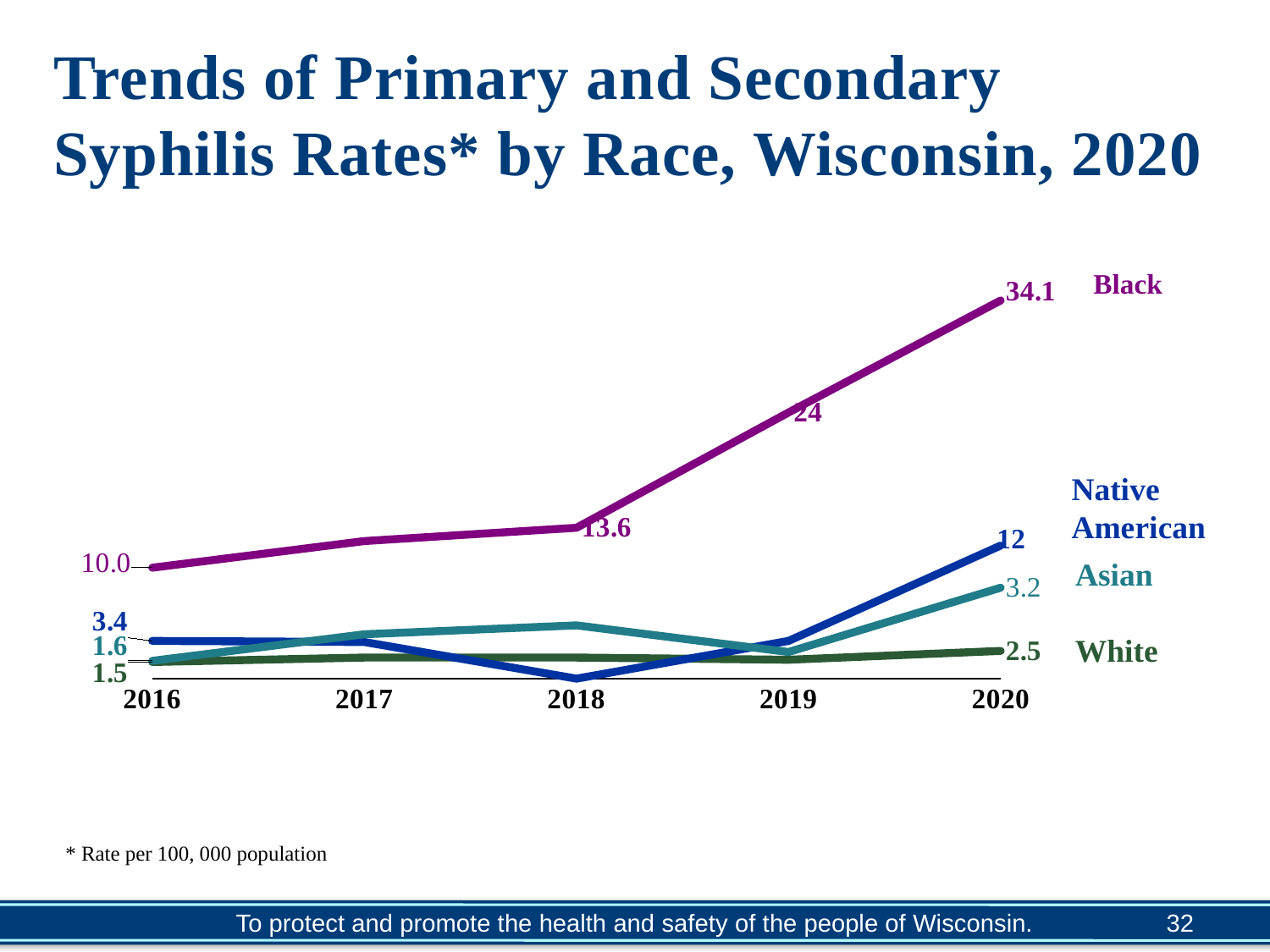
What was the rate for the Black population in 2019? 24 What was the rate for the Asian population in 2020? 3.2 What was the rate for the Native American population in 2020? 12 How many race groups are plotted as lines on the chart? 4 Which race had the lowest syphilis rate in 2020? White By how much did the rate for the Black population increase from 2019 to 2020? 10.1 What was the primary and secondary syphilis rate for the Black population in 2020? 34.1 What kind of chart is shown on the slide? line chart How many years are shown on the x axis? 5 What was the rate for the White population in 2016? 1.5 What was the rate for the Black population in 2018? 13.6 Which race had the highest syphilis rate in 2020? Black